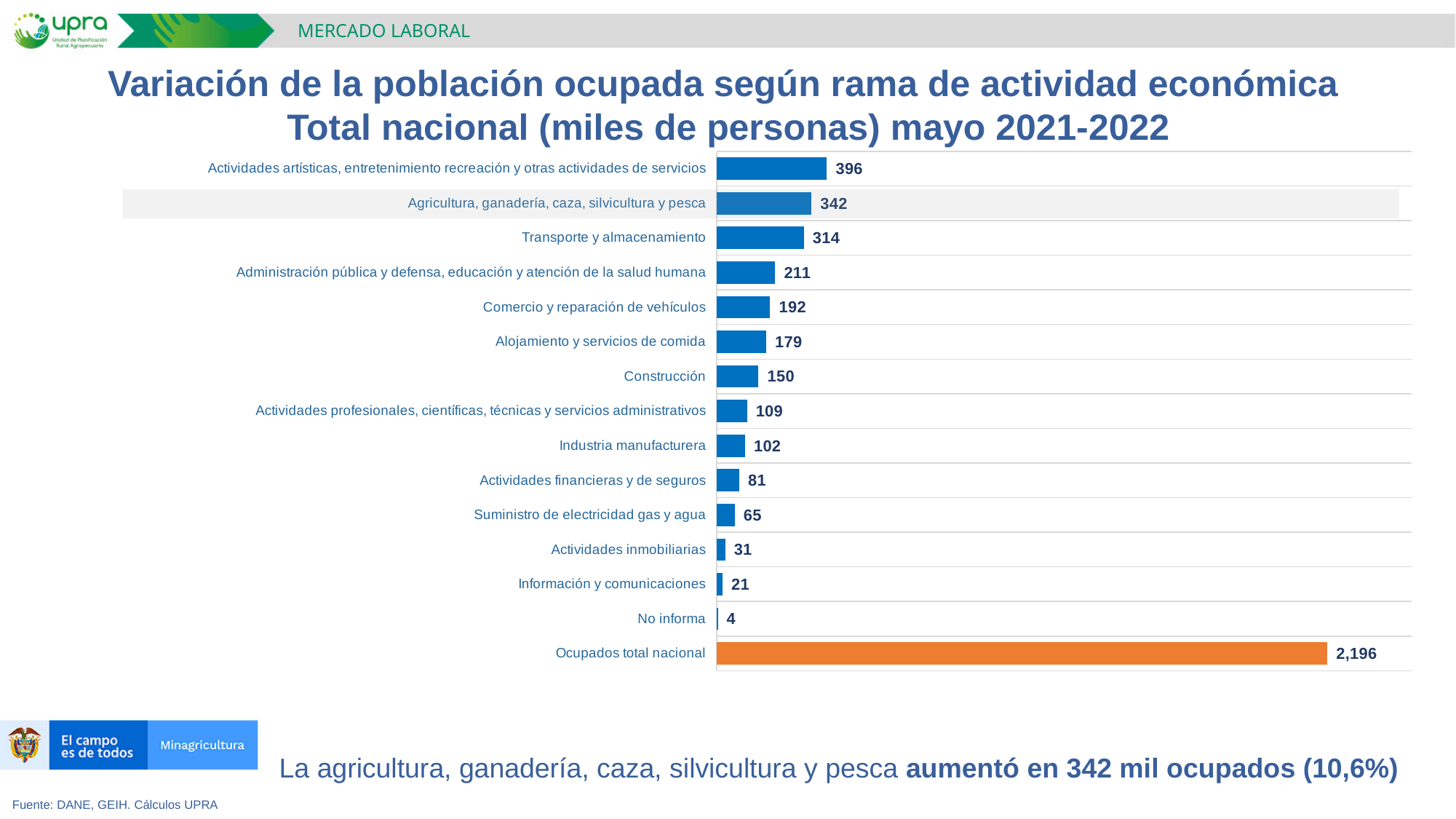
What is the value for Ocupados total nacional? 2,196 What is the value for Agricultura, ganadería, caza, silvicultura y pesca? 342 What is the value for Transporte y almacenamiento? 314 What kind of chart is shown on the slide? Bar chart Which bar is shown in orange rather than blue? Ocupados total nacional How many categories are shown in the chart? 15 What is the difference between the values for Industria manufacturera and Actividades financieras y de seguros? 21 What is the difference between the values for Actividades artísticas, entretenimiento recreación y otras actividades de servicios and Agricultura, ganadería, caza, silvicultura y pesca? 54 What is the value for Construcción? 150 Excluding the Ocupados total nacional bar, which category has the highest value? Actividades artísticas, entretenimiento recreación y otras actividades de servicios Which category has the lowest value? No informa Which is larger, the value for Comercio y reparación de vehículos or the value for Alojamiento y servicios de comida? Comercio y reparación de vehículos